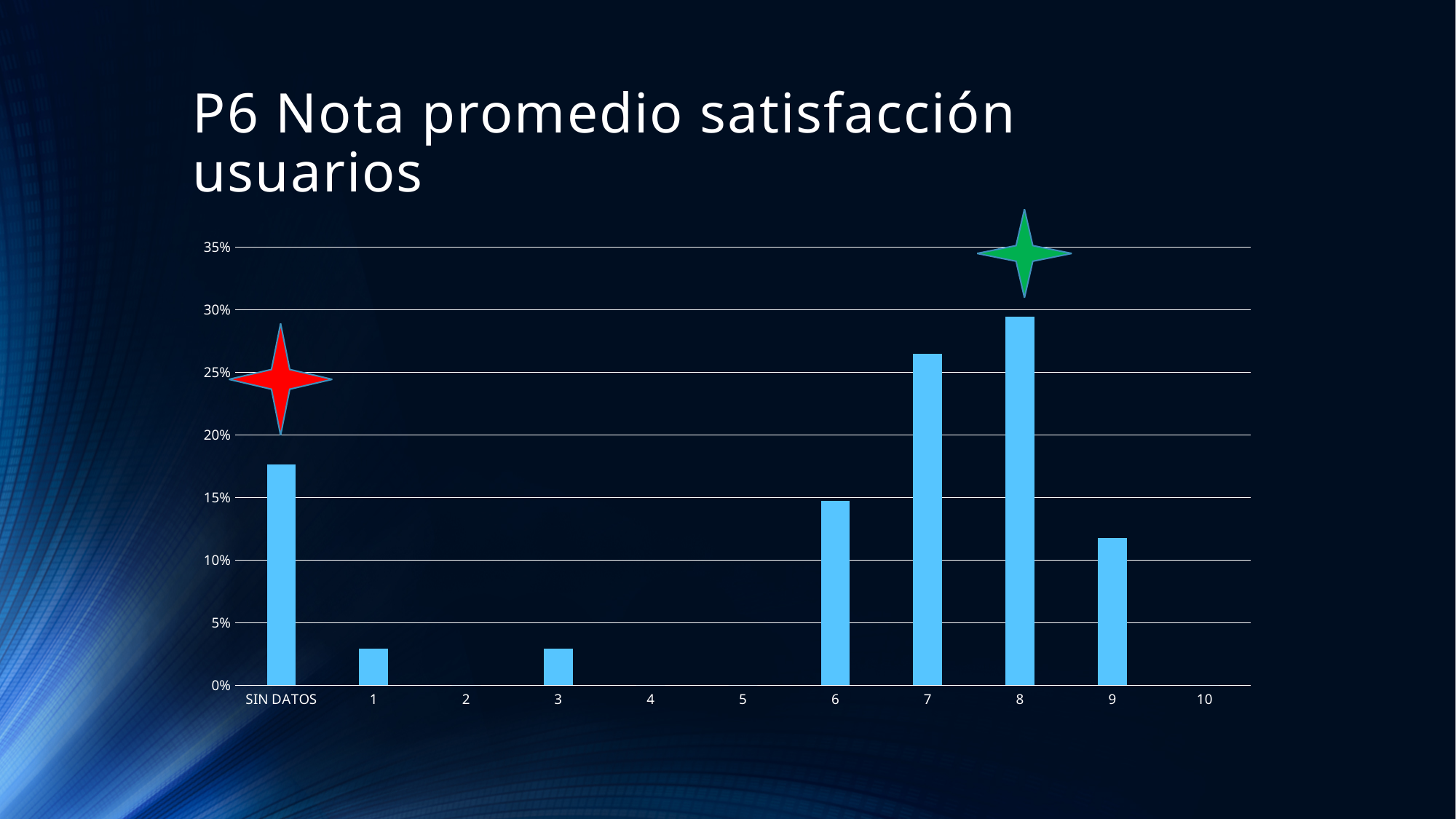
Which category has the highest bar? 8 Which is larger, the value for SIN DATOS or the value for 6? SIN DATOS What is the title of the slide? P6 Nota promedio satisfacción usuarios Is the value for 8 greater or less than 30%? less Is the value for 9 greater or less than 10%? greater How many categories are shown on the x axis? 11 Is the value for 1 greater or less than 5%? less How many categories have a visible bar above 0%? 7 Which is larger, the value for 7 or the value for 9? 7 What kind of chart is shown on the slide? bar chart